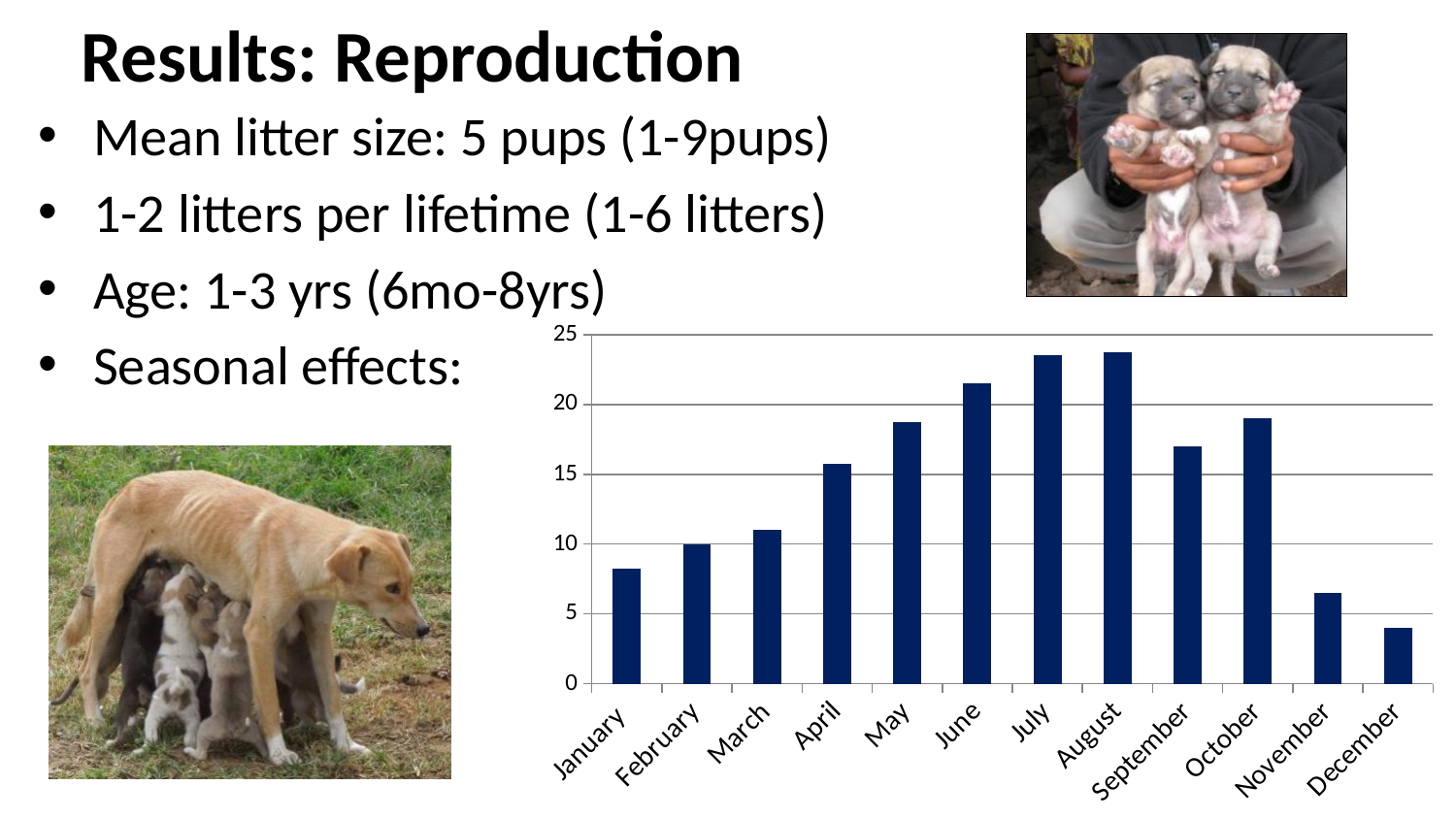
Which month has the lowest bar in the chart? December Is the value for July greater or less than 20? greater Which is larger, the value for October or the value for September? October Is the value for December greater or less than 5? less Is the value for November greater or less than 10? less What kind of chart is shown on the slide? bar chart Do the values rise or fall from January to August? rise How many months are plotted on the x axis of the chart? 12 Which is larger, the value for June or the value for March? June Do the values rise or fall from October to December? fall